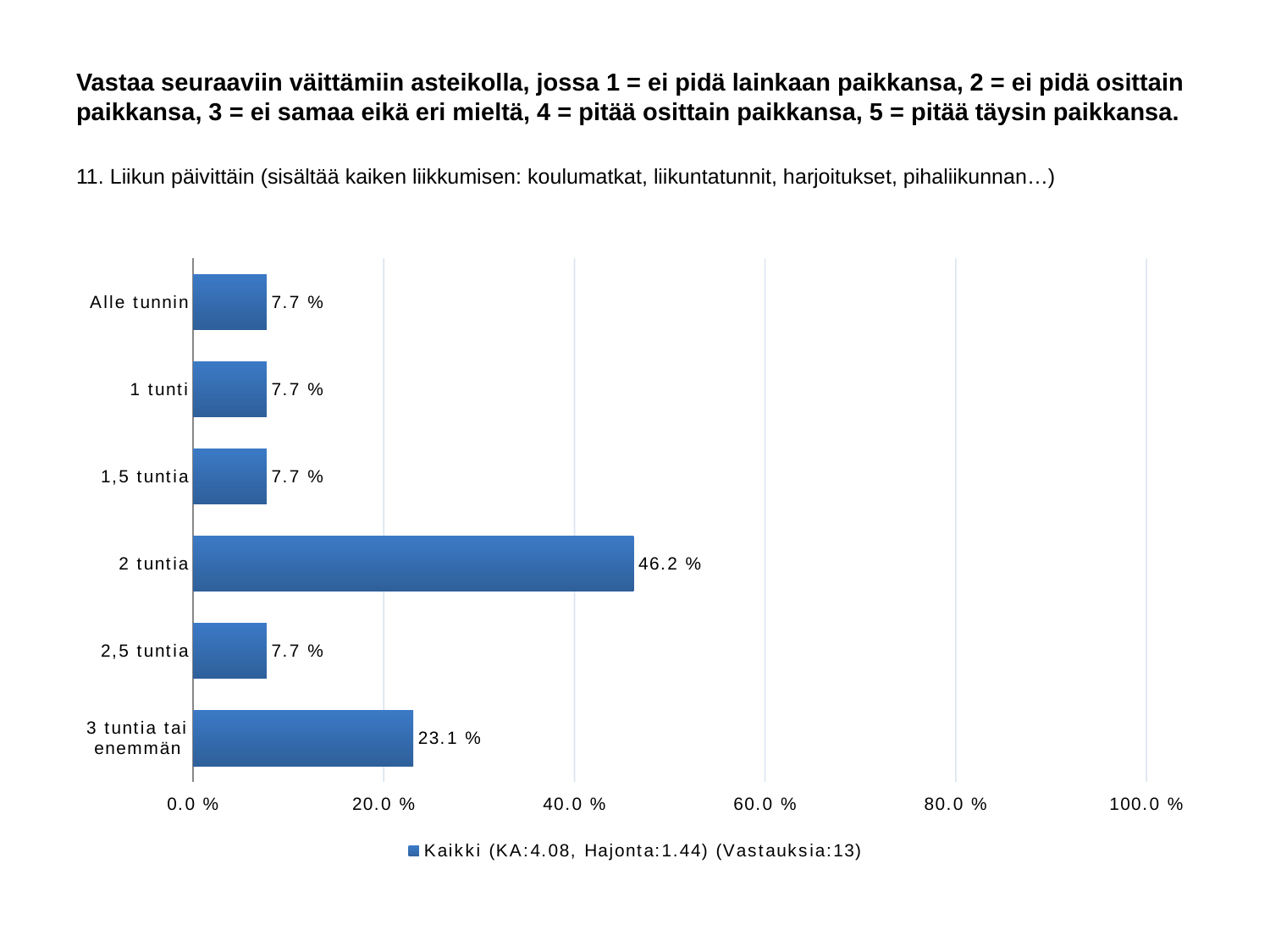
Is the value for "1,5 tuntia" greater or less than 20.0 %? less How many responses (Vastauksia) does the legend entry report? 13 Which is larger, the value for "1 tunti" or the value for "3 tuntia tai enemmän"? 3 tuntia tai enemmän What kind of chart is shown on the slide? bar chart What is the value for "2 tuntia"? 46.2 % What is the difference between the values for "2 tuntia" and "3 tuntia tai enemmän"? 23.1 % How many categories are shown in the chart? 6 What is the value for "Alle tunnin"? 7.7 % Is the value for "2 tuntia" greater or less than 40.0 %? greater What is the value for "2,5 tuntia"? 7.7 % Which category has the highest value? 2 tuntia What is the value for "3 tuntia tai enemmän"? 23.1 %